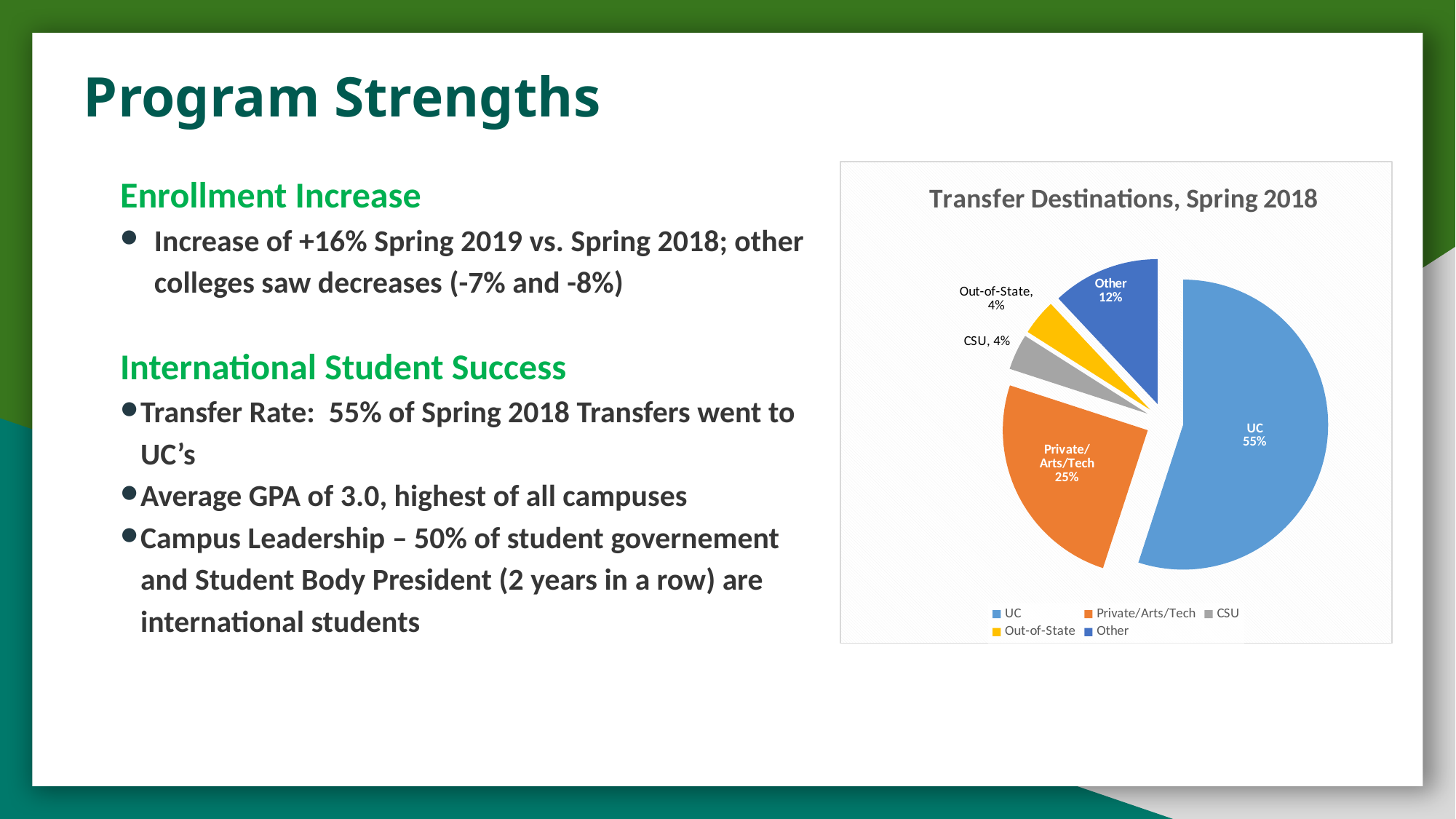
What type of chart is shown on the slide? Pie chart How many categories does the pie chart show? 5 What percentage of transfers went to CSU? 4% Which transfer destination has the largest share? UC What colour is the UC slice in the pie chart? Blue What is the title of the chart? Transfer Destinations, Spring 2018 What percentage of transfers went to Other destinations? 12% What is the difference in percentage points between UC and Private/Arts/Tech? 30 What percentage of transfers went to UC? 55% Which is larger, the share for Other or the share for Out-of-State? Other What percentage of transfers went to Private/Arts/Tech? 25% What is the difference in percentage points between Other and CSU? 8